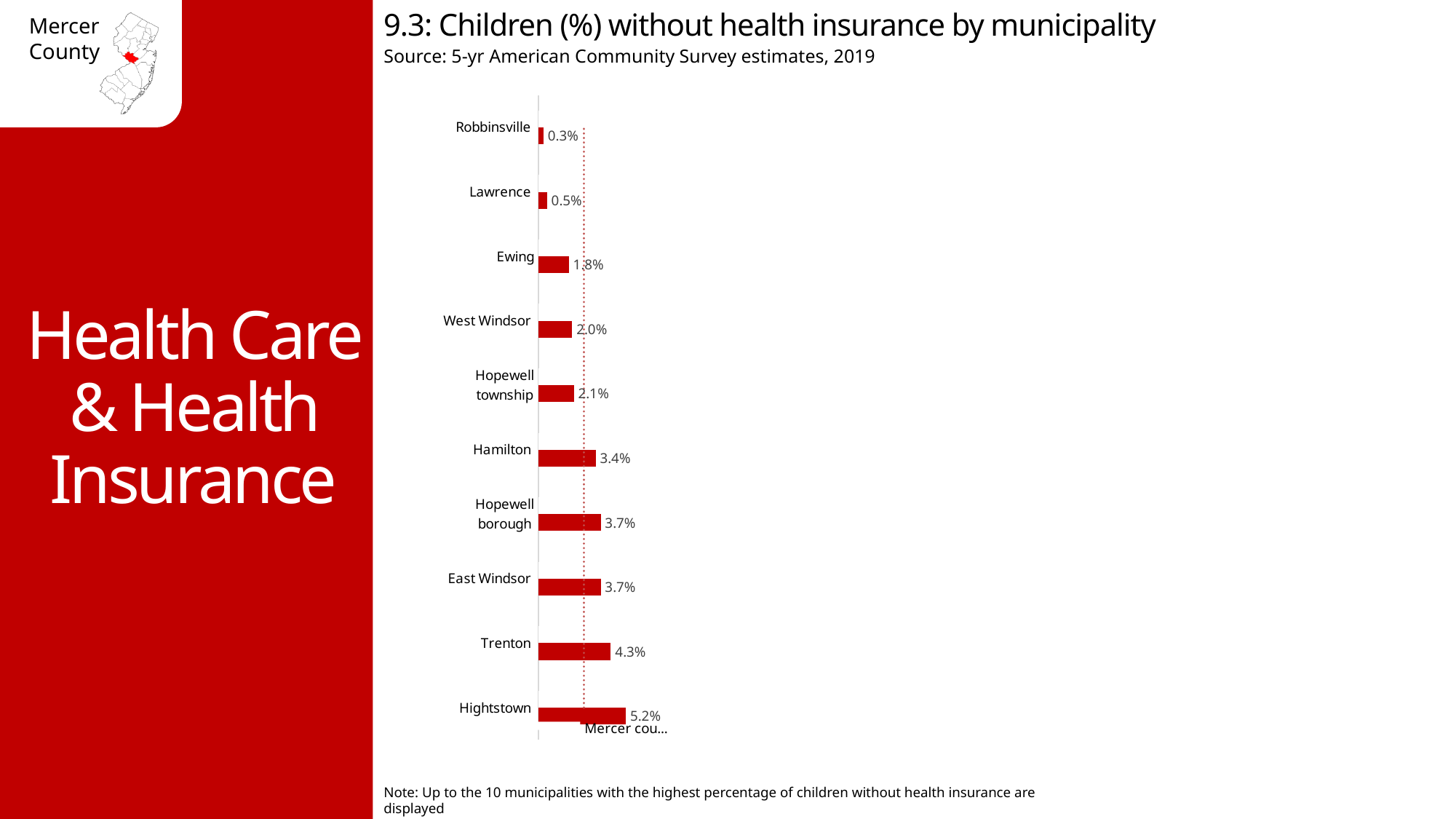
What is the difference between the values for Hightstown and Trenton? 0.9% How many municipalities are shown in the chart? 10 What percentage of children are without health insurance in Hightstown? 5.2% Which municipality has the lowest percentage of children without health insurance? Robbinsville Which has a larger value, West Windsor or Hamilton? Hamilton What is the source cited for the chart? 5-yr American Community Survey estimates, 2019 What is the difference between the values for Hamilton and Ewing? 1.6% What is the value shown for Trenton? 4.3% Which municipality has the highest percentage of children without health insurance? Hightstown What is the value for Lawrence? 0.5% What percentage is shown for Hopewell township? 2.1% What type of chart is shown on the slide? Bar chart